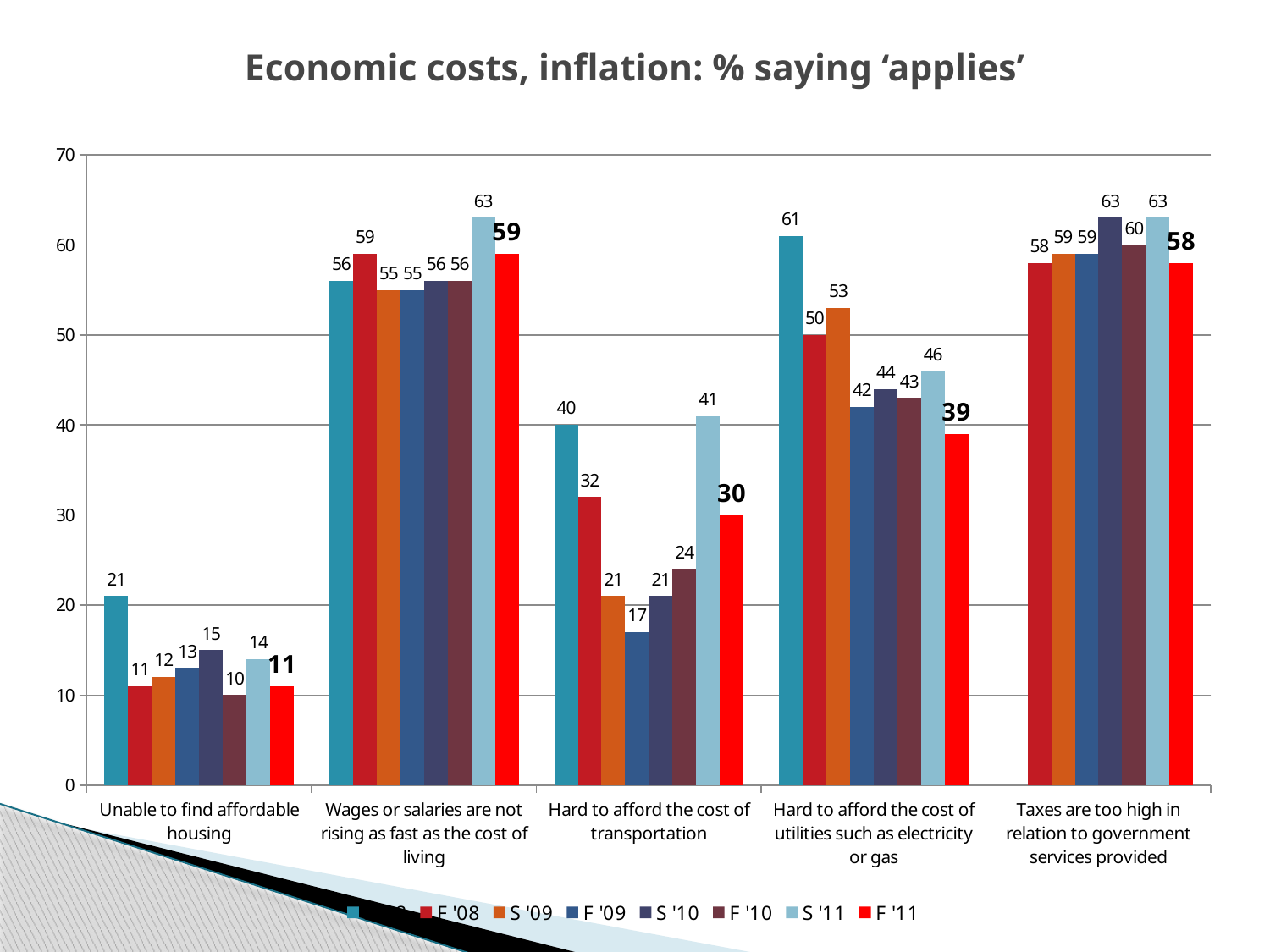
What kind of chart is shown on the slide? bar chart For 'Hard to afford the cost of transportation', which is larger: the F '08 value or the F '11 value? F '08 Among the F '11 values, which category has the highest value? Wages or salaries are not rising as fast as the cost of living For 'Hard to afford the cost of transportation', what is the difference between the S '11 value and the F '09 value? 24 Is the F '11 value for 'Hard to afford the cost of utilities such as electricity or gas' greater or less than 40? less What is the S '11 value for 'Wages or salaries are not rising as fast as the cost of living'? 63 For 'Hard to afford the cost of utilities such as electricity or gas', what is the difference between the S '11 value and the F '11 value? 7 What is the F '11 value for 'Hard to afford the cost of transportation'? 30 How many categories are shown on the x axis? 5 Among the F '11 values, which category has the lowest value? Unable to find affordable housing What is the F '11 value for 'Unable to find affordable housing'? 11 What is the F '10 value for 'Hard to afford the cost of utilities such as electricity or gas'? 43